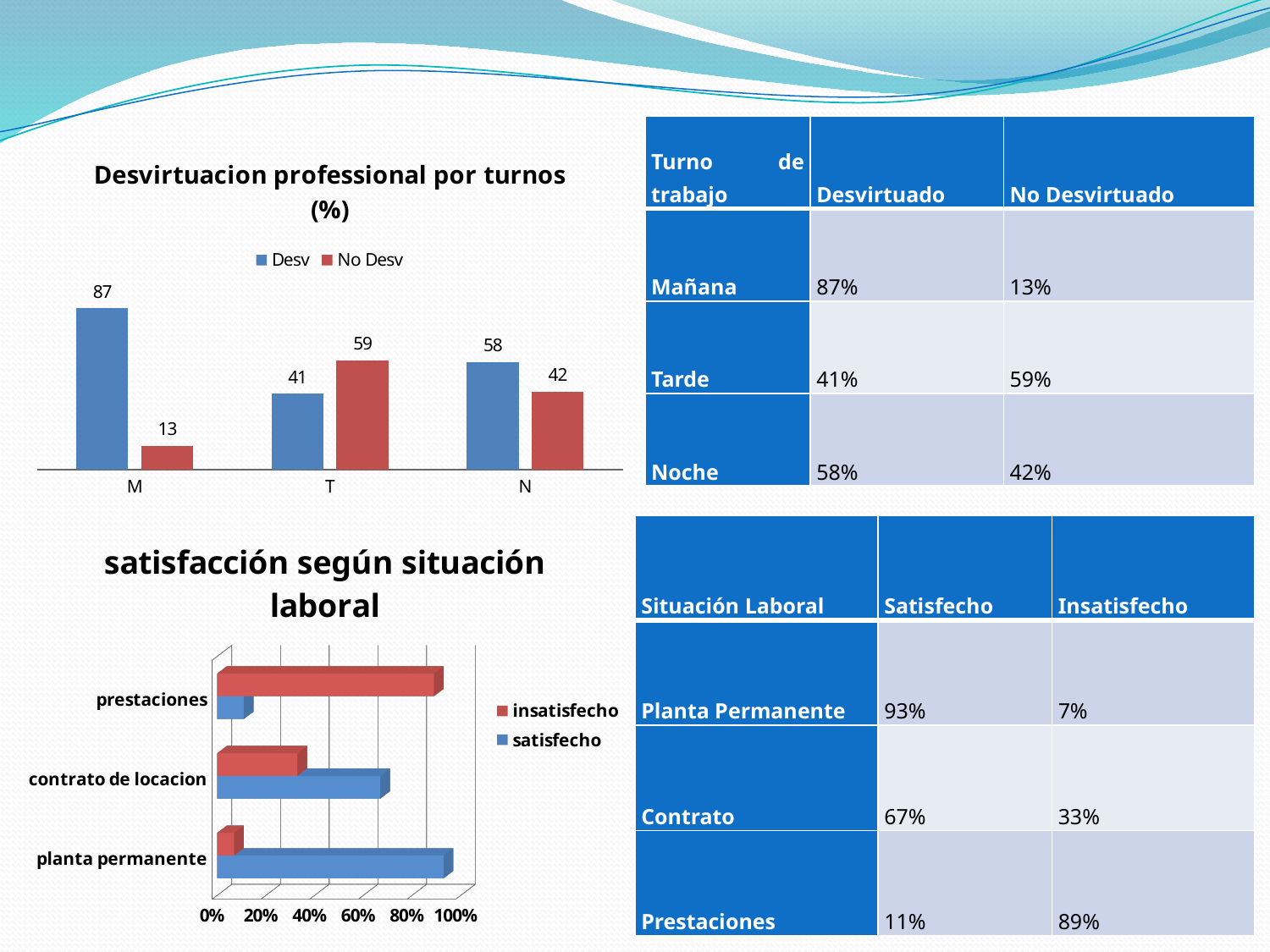
What kind of chart is 'satisfacción según situación laboral'? Bar chart In the chart 'Desvirtuacion professional por turnos (%)', which category has the lowest No Desv value? M In the chart 'Desvirtuacion professional por turnos (%)', what is the Desv value for M? 87 In the chart 'Desvirtuacion professional por turnos (%)', what is the No Desv value for N? 42 In the chart 'Desvirtuacion professional por turnos (%)', what is the No Desv value for T? 59 In the chart 'Desvirtuacion professional por turnos (%)', which category has the highest Desv value? M In the chart 'satisfacción según situación laboral', how many categories are shown? 3 In the chart 'satisfacción según situación laboral', is the satisfecho value for prestaciones greater or less than 20%? less In the chart 'satisfacción según situación laboral', is the satisfecho value for planta permanente greater or less than 80%? greater In the chart 'Desvirtuacion professional por turnos (%)', is the Desv value or the No Desv value larger for T? No Desv In the chart 'Desvirtuacion professional por turnos (%)', what is the difference between the Desv and No Desv values for N? 16 In the chart 'Desvirtuacion professional por turnos (%)', how many series does the legend list? 2